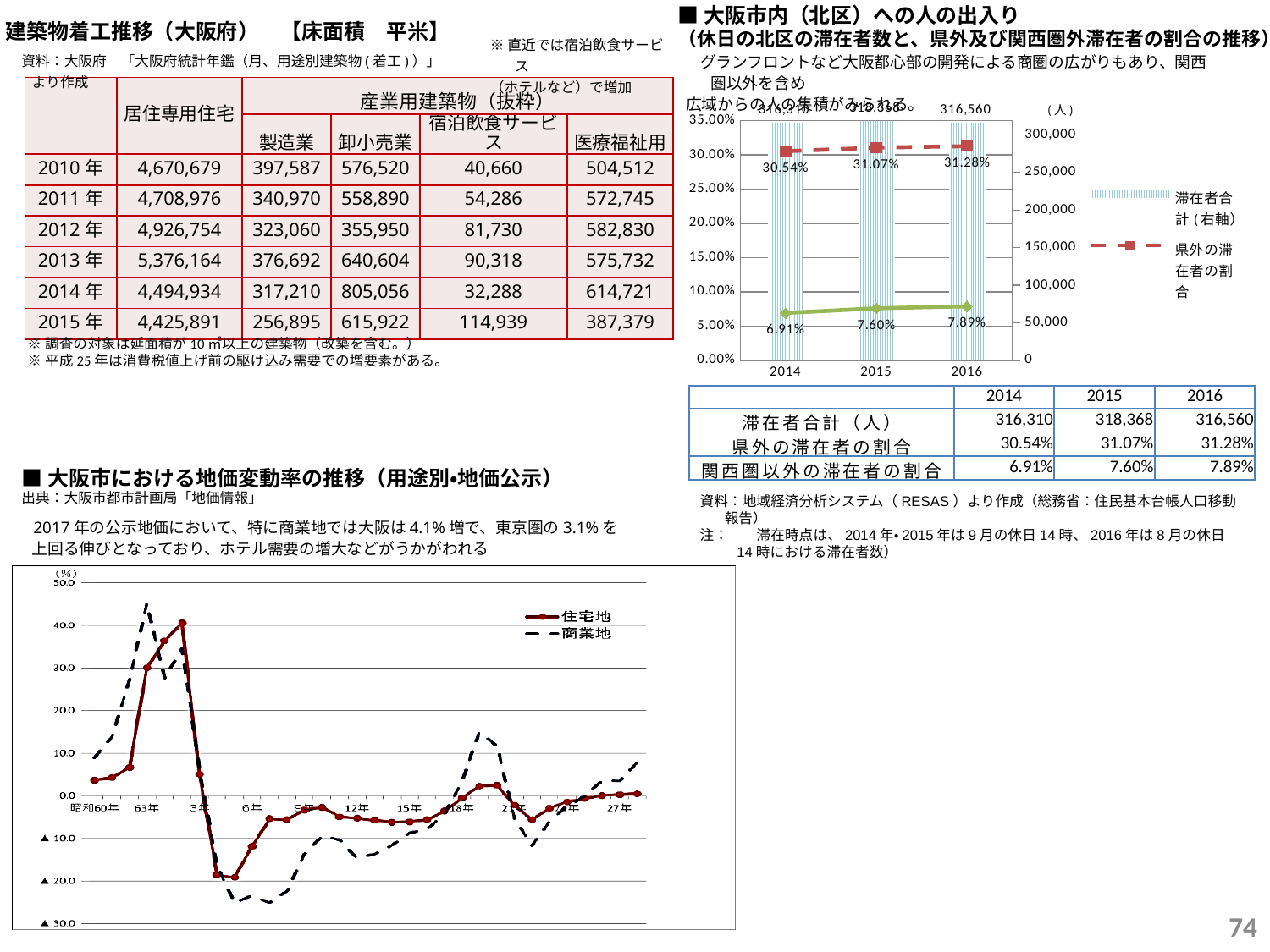
In the top-right chart (大阪市内（北区）への人の出入り), how many years are shown on the x axis? 3 In the top-right chart (大阪市内（北区）への人の出入り), what is the value of 滞在者合計 for 2015? 318,368 In the bottom-left chart (大阪市における地価変動率の推移), is the 住宅地 value at 3年 greater or less than 30.0? less In the top-right chart (大阪市内（北区）への人の出入り), is the 県外の滞在者の割合 higher in 2014 or in 2016? 2016 In the top-right chart (大阪市内（北区）への人の出入り), what is the difference in 滞在者合計 between 2015 and 2014? 2,058 In the top-right chart (大阪市内（北区）への人の出入り), what is the 関西圏以外の滞在者の割合 for 2014? 6.91% In the top-right chart (大阪市内（北区）への人の出入り), does the 関西圏以外の滞在者の割合 rise or fall from 2014 to 2016? rise In the top-right chart (大阪市内（北区）への人の出入り), what is the 県外の滞在者の割合 for 2016? 31.28% How many series does the legend of the bottom-left chart (大阪市における地価変動率の推移) list? 2 In the top-right chart (大阪市内（北区）への人の出入り), which year has the highest 滞在者合計? 2015 In the top-right chart (大阪市内（北区）への人の出入り), which year has the lowest 関西圏以外の滞在者の割合? 2014 What kind of chart is the bottom-left chart (大阪市における地価変動率の推移)? line chart